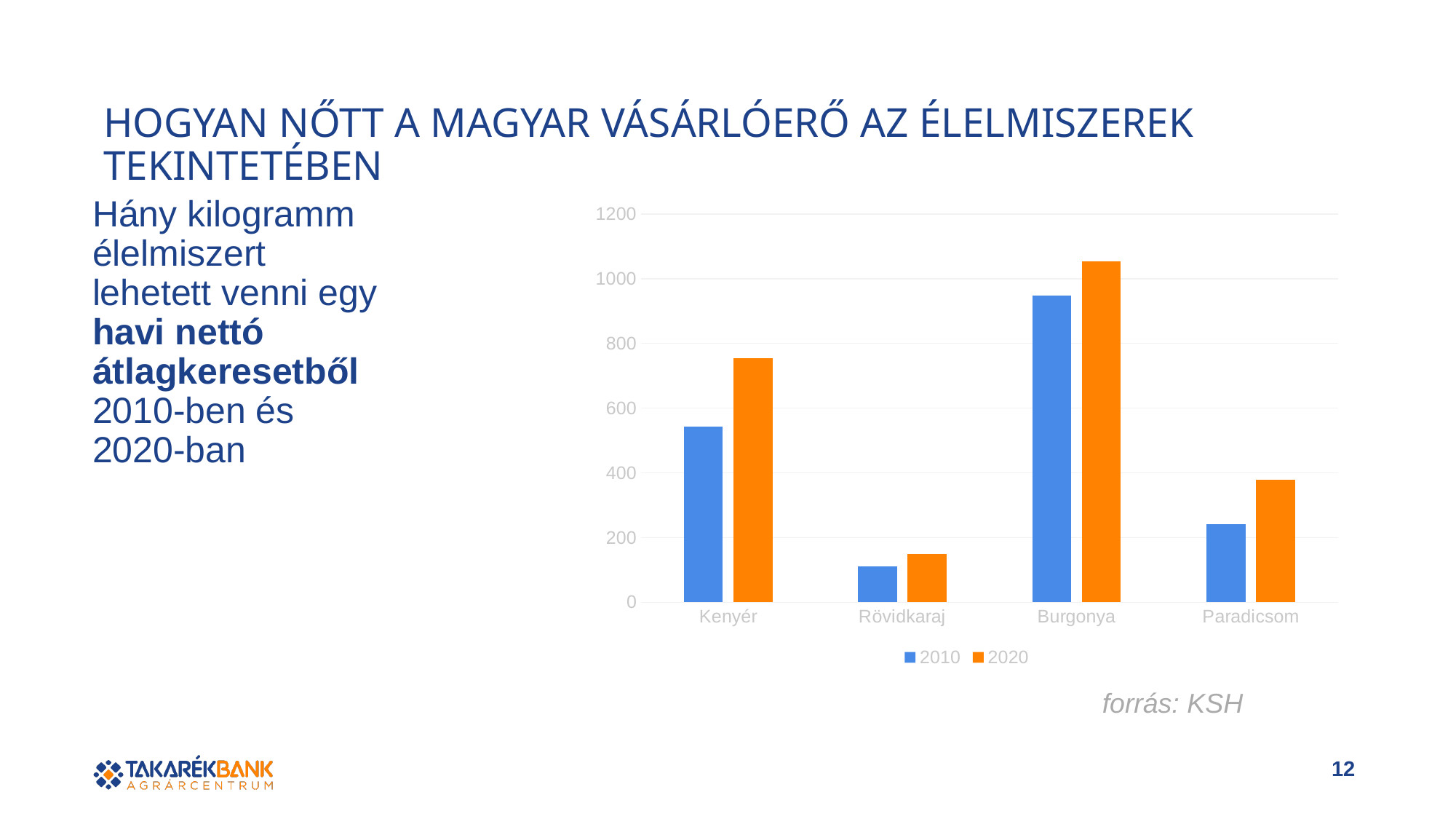
For Kenyér, which series has the larger value, 2010 or 2020? 2020 Is the 2010 value for Rövidkaraj greater or less than 200? less Which category has the lowest value for the 2010 series? Rövidkaraj Which category has the highest value for the 2020 series? Burgonya How many series does the chart's legend list? 2 Is the 2020 value for Burgonya greater or less than 1000? greater Which is larger: the 2010 value for Paradicsom or the 2010 value for Kenyér? Kenyér Which series is shown in orange in the chart? 2020 What source is cited below the chart? KSH Is the 2020 value for Kenyér greater or less than 600? greater How many categories are shown on the x axis of the chart? 4 What kind of chart is shown on the slide? bar chart